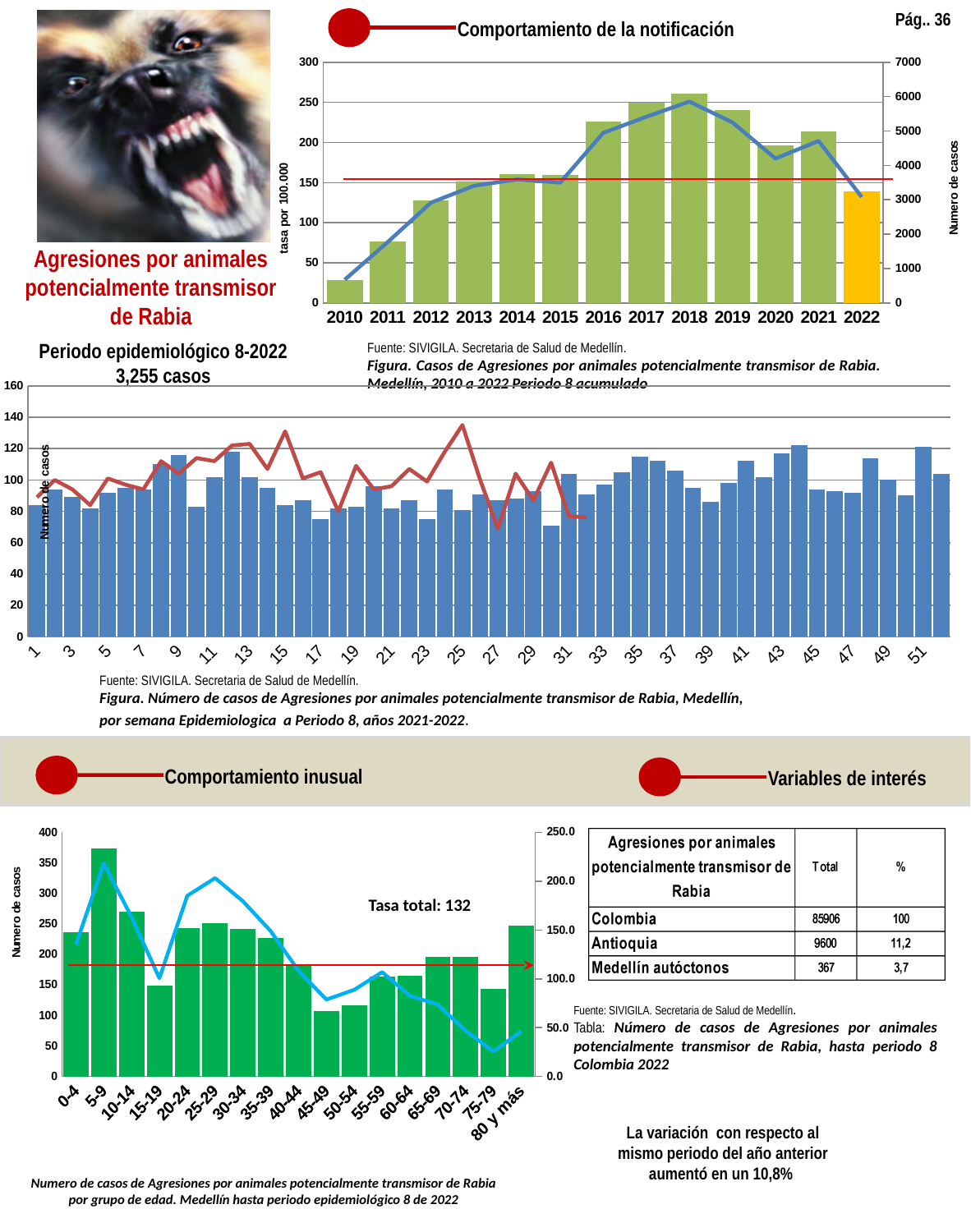
In the age-group chart at the bottom left, which age group has the larger bar, 10-14 or 15-19? 10-14 In the age-group chart at the bottom left, how many age groups are shown on the x axis? 17 In the chart of cases by epidemiological week (middle of the slide), how many weeks are shown on the x axis? 52 In the 'Comportamiento de la notificación' chart, which year has the tallest bar? 2018 What kind of chart is the 'Comportamiento de la notificación' chart at the top of the slide? combination bar and line chart In the age-group chart at the bottom left, which age group has the tallest bar? 5-9 In the 'Comportamiento de la notificación' chart, which year has the shortest bar? 2010 In the 'Comportamiento de la notificación' chart, is the number of cases for 2018 greater or less than 5000? greater In the chart of cases by epidemiological week (middle of the slide), is the bar for week 44 greater or less than 100? greater In the 'Comportamiento de la notificación' chart, do the bars rise or fall from 2010 to 2018? rise In the 'Comportamiento de la notificación' chart, how many years are shown on the x axis? 13 In the 'Comportamiento de la notificación' chart, which year has the larger bar, 2012 or 2017? 2017